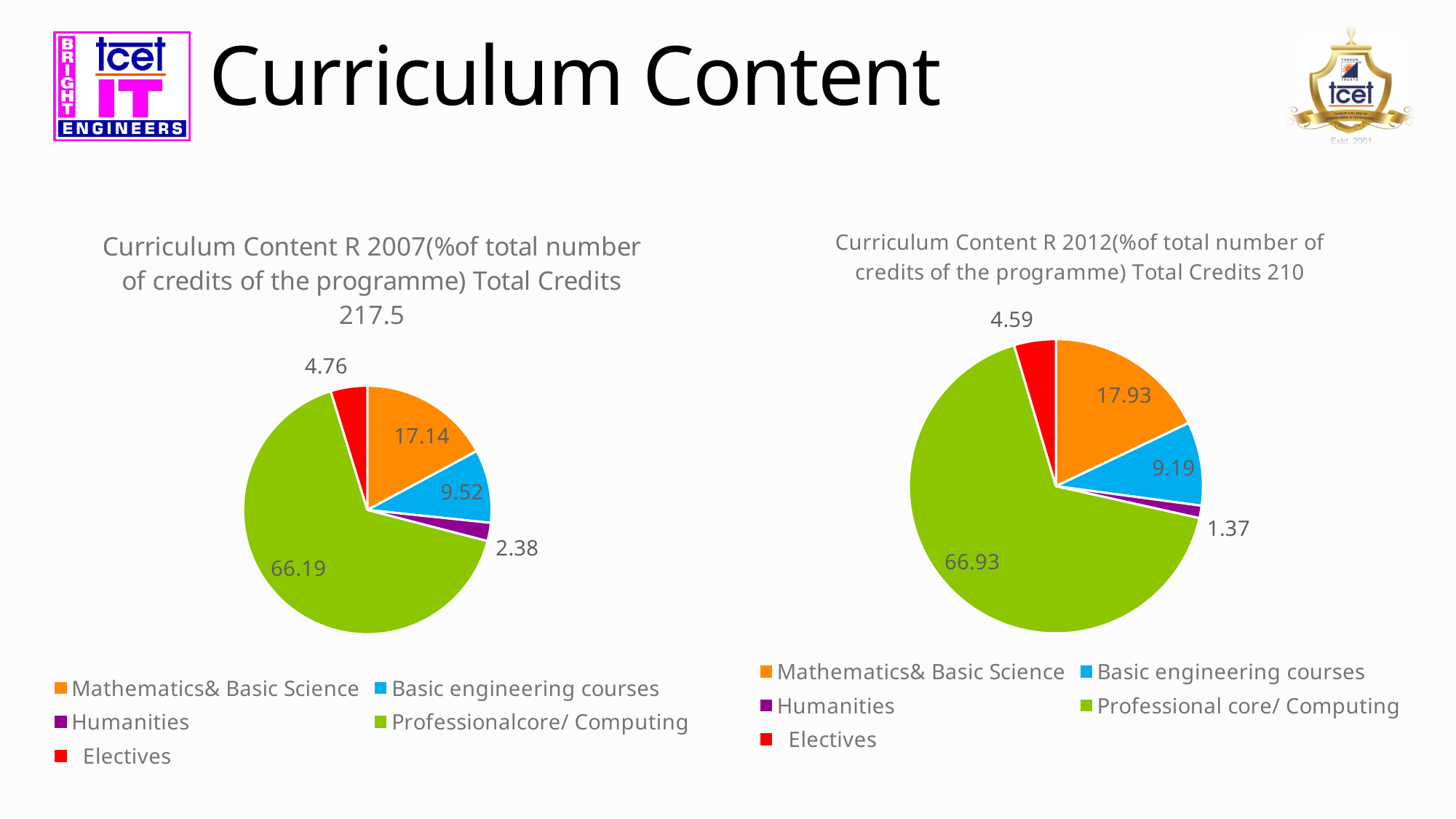
What type of chart is the R 2007 chart on the left? Pie chart In the R 2007 chart on the left, what is the value for Professionalcore/ Computing? 66.19 In the R 2012 chart on the right, what is the difference between the values for Basic engineering courses and Electives? 4.6 In the R 2007 chart on the left, what is the difference between the values for Mathematics& Basic Science and Basic engineering courses? 7.62 In the R 2012 chart on the right, what is the value for Electives? 4.59 How many categories does the R 2012 chart on the right show? 5 In the R 2012 chart on the right, what is the value for Mathematics& Basic Science? 17.93 In the R 2007 chart on the left, which is larger: Electives or Humanities? Electives In the R 2007 chart on the left, what is the value for Humanities? 2.38 What total credits figure is stated in the title of the R 2012 chart on the right? 210 In the R 2012 chart on the right, which category has the smallest slice? Humanities In the R 2007 chart on the left, which category has the largest slice? Professionalcore/ Computing